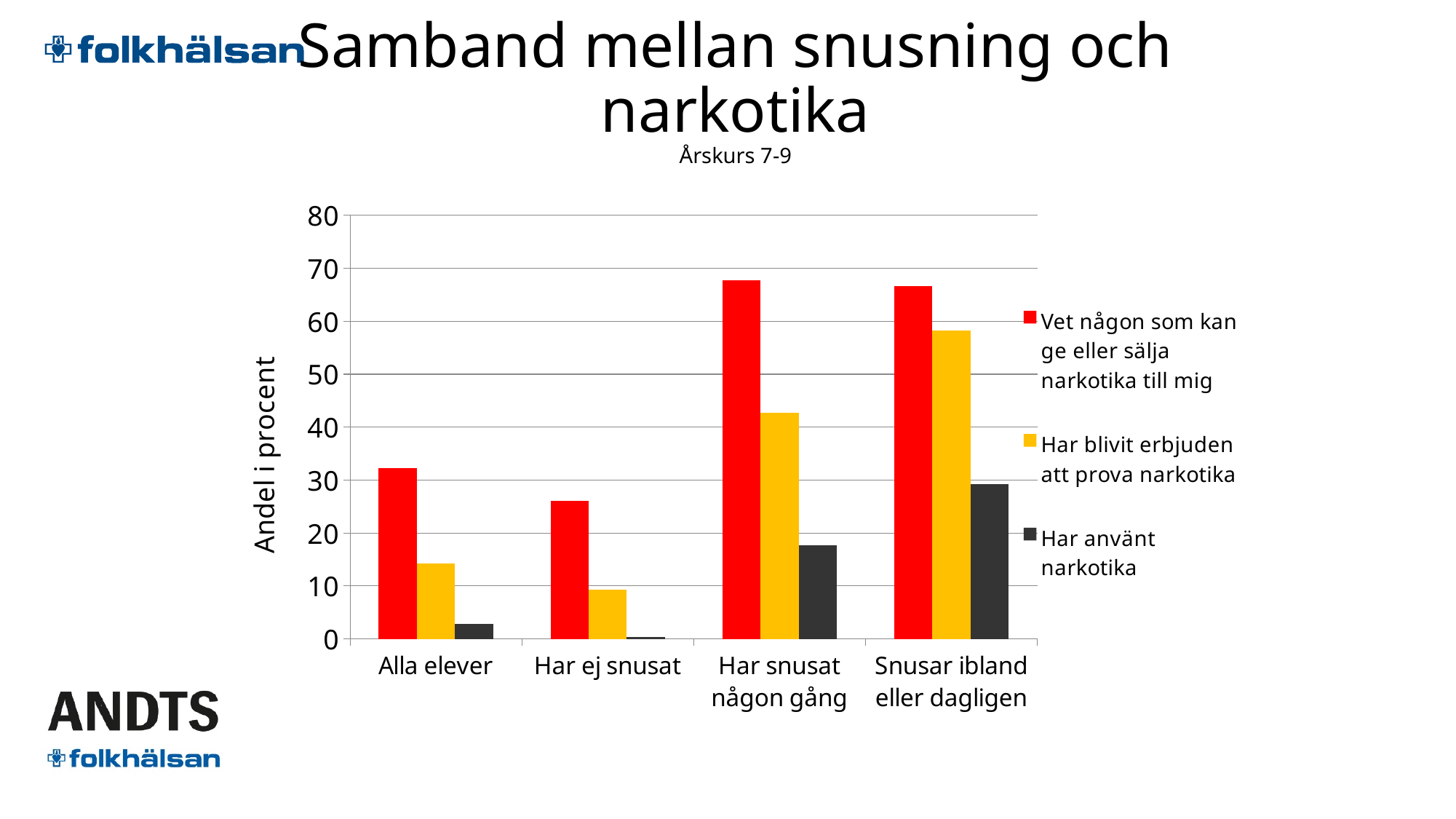
How many categories are shown on the x axis? 4 Which category has the lowest value for 'Har använt narkotika'? Har ej snusat Is the value for 'Vet någon som kan ge eller sälja narkotika till mig' in the 'Har ej snusat' category greater or less than 20? greater Which category has the highest value for 'Har blivit erbjuden att prova narkotika'? Snusar ibland eller dagligen What is the label of the y axis? Andel i procent Is the value for 'Har använt narkotika' in the 'Har snusat någon gång' category greater or less than 20? less Which is larger: 'Har använt narkotika' for 'Alla elever' or for 'Snusar ibland eller dagligen'? Snusar ibland eller dagligen Which category has the lowest value for 'Vet någon som kan ge eller sälja narkotika till mig'? Har ej snusat How many series does the legend list? 3 Is the value for 'Har blivit erbjuden att prova narkotika' in the 'Har snusat någon gång' category greater or less than 40? greater What kind of chart is shown on the slide? bar chart